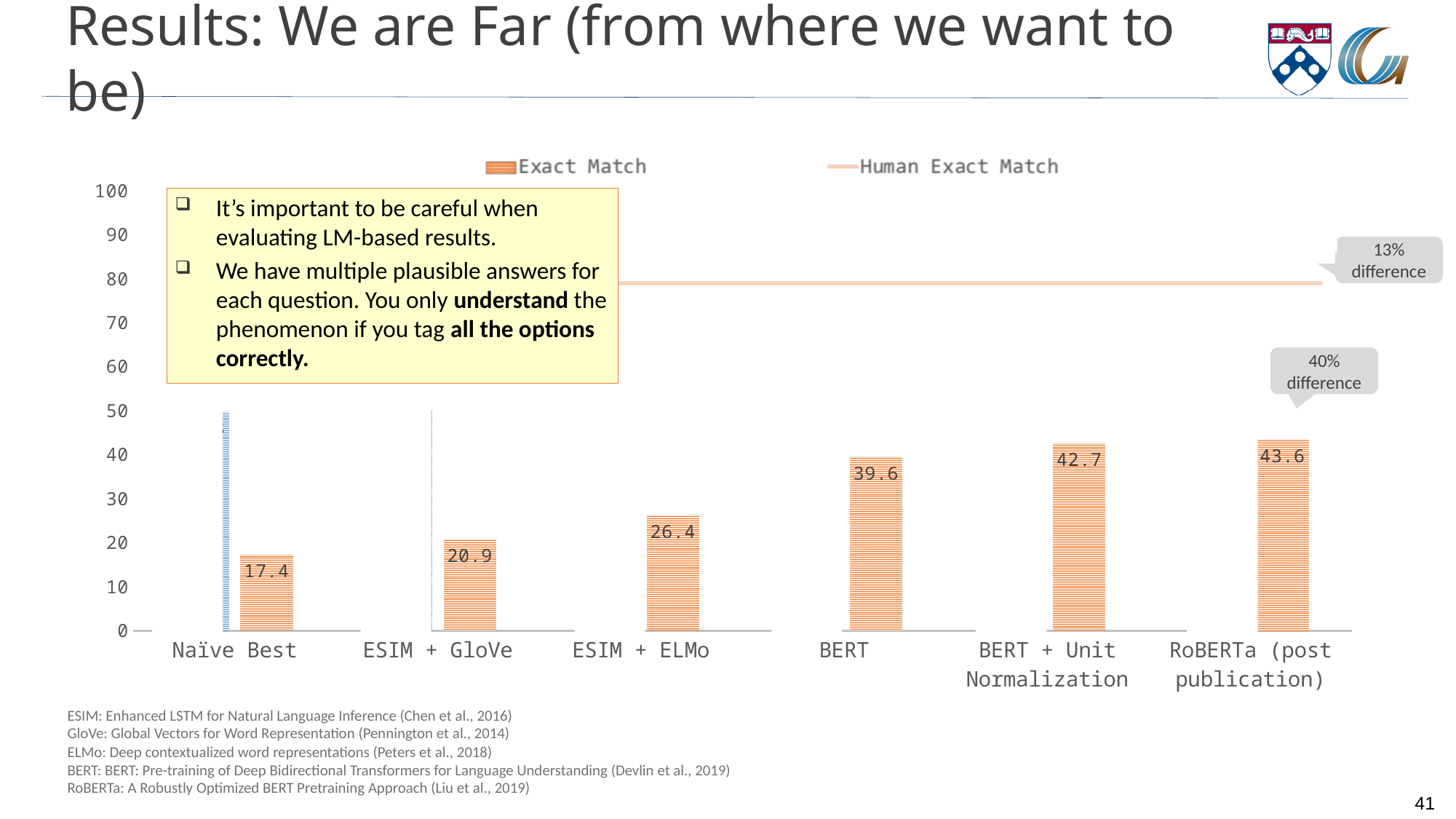
What is the Exact Match value for ESIM + ELMo? 26.4 What is the Exact Match value for BERT? 39.6 What is the Exact Match value for RoBERTa (post publication)? 43.6 Which has a higher Exact Match value, ESIM + GloVe or ESIM + ELMo? ESIM + ELMo Which category has the highest Exact Match value? RoBERTa (post publication) How many series does the legend list? 2 What is the difference in Exact Match between BERT + Unit Normalization and BERT? 3.1 What is the Exact Match value for Naïve Best? 17.4 Do the Exact Match values rise or fall from Naïve Best to RoBERTa (post publication)? rise How many categories are shown on the x axis? 6 Is the Human Exact Match line greater or less than 70? greater Which category has the lowest Exact Match value? Naïve Best